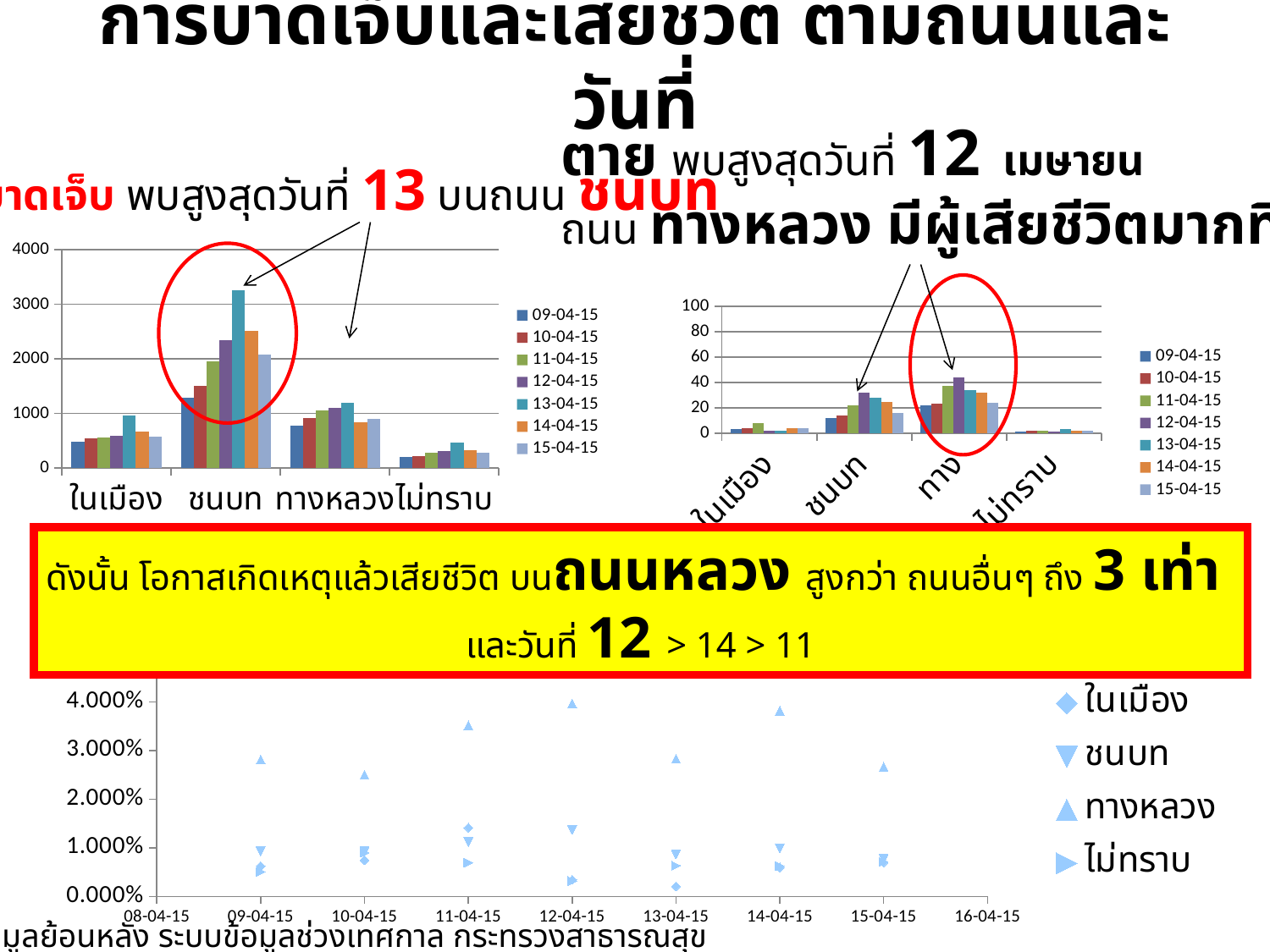
What kind of chart is the top-left chart? bar chart How many series does the legend of the top-left bar chart list? 7 In the top-right bar chart, is the value for ชนบท on 12-04-15 greater or less than 20? greater In the top-left bar chart, which category has the tallest bar? ชนบท What kind of chart is the chart at the bottom of the slide? scatter chart In the top-right bar chart, which series has the tallest bar for ทาง? 12-04-15 How many series does the legend of the bottom scatter chart list? 4 In the top-left bar chart, is the value for ไม่ทราบ on 13-04-15 greater or less than 1000? less In the top-left bar chart, is the value for ชนบท on 13-04-15 greater or less than 3000? greater How many categories are shown on the x axis of the top-left bar chart? 4 In the top-left bar chart, which series has the tallest bar for ชนบท? 13-04-15